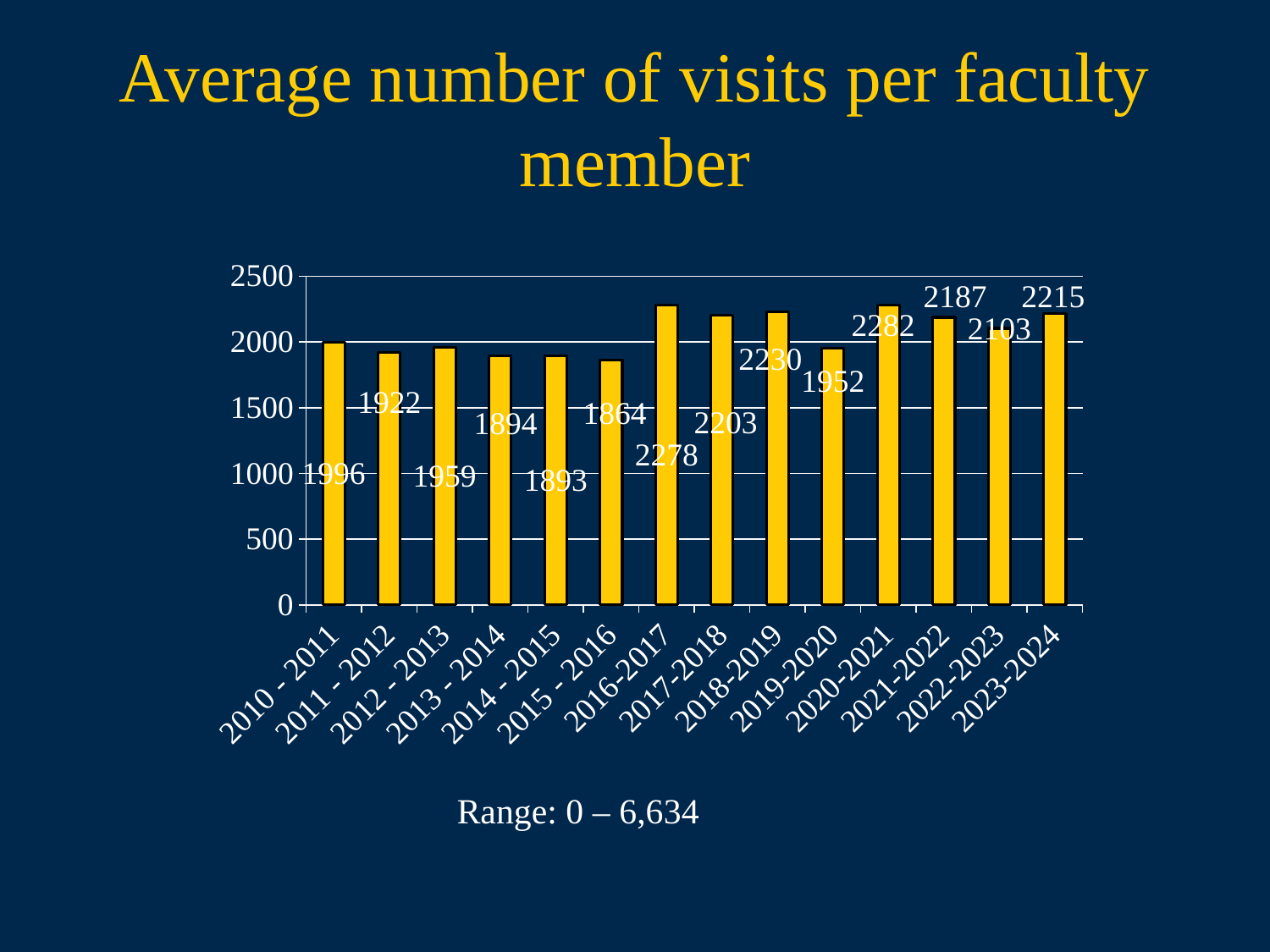
Which academic year has the lowest average number of visits per faculty member? 2015 - 2016 What is the value for 2019-2020? 1952 What is the difference between the values for 2010 - 2011 and 2011 - 2012? 74 What is the value for 2016-2017? 2278 Which is larger, the value for 2016-2017 or the value for 2015 - 2016? 2016-2017 What is the title of the chart? Average number of visits per faculty member What is the average number of visits per faculty member for 2010 - 2011? 1996 Is the value for 2018-2019 greater or less than 2000? greater What kind of chart is shown on the slide? bar chart What is the value for 2023-2024? 2215 How many academic years are shown on the x axis? 14 What is the difference between the values for 2023-2024 and 2022-2023? 112